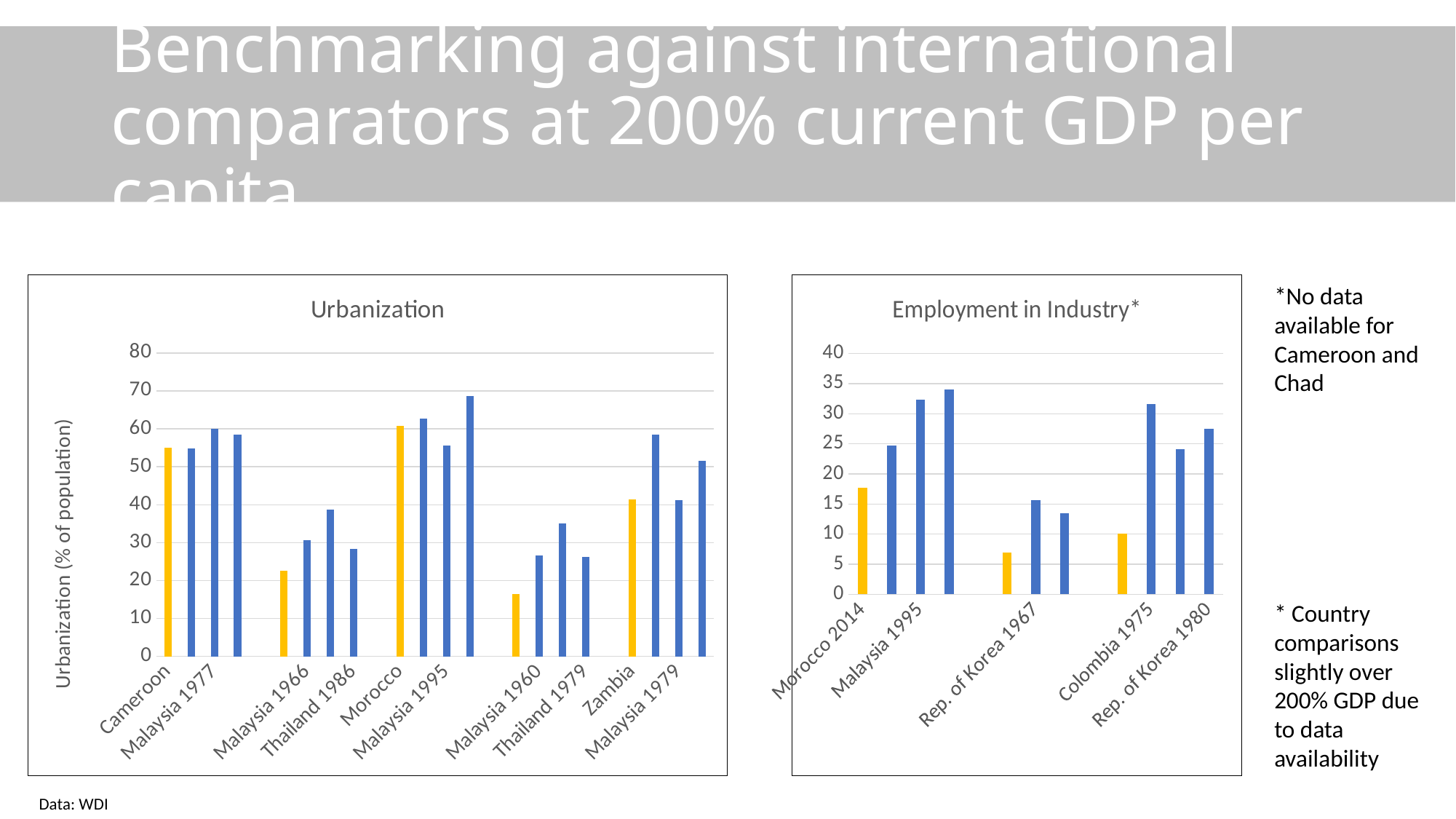
In the Urbanization chart, is the value for Thailand 1979 greater or less than 30? less In the Urbanization chart, is the value for Cameroon greater or less than 50? greater In the Urbanization chart, which is larger, the value for Cameroon or the value for Malaysia 1966? Cameroon In the Employment in Industry chart, is the value for Malaysia 1995 greater or less than 30? greater What kind of chart is the Urbanization chart? bar chart What is the y-axis title of the Urbanization chart? Urbanization (% of population) In the Employment in Industry chart, which is larger, the value for Malaysia 1995 or the value for Morocco 2014? Malaysia 1995 According to the note next to the Employment in Industry chart, which two countries have no data available? Cameroon and Chad